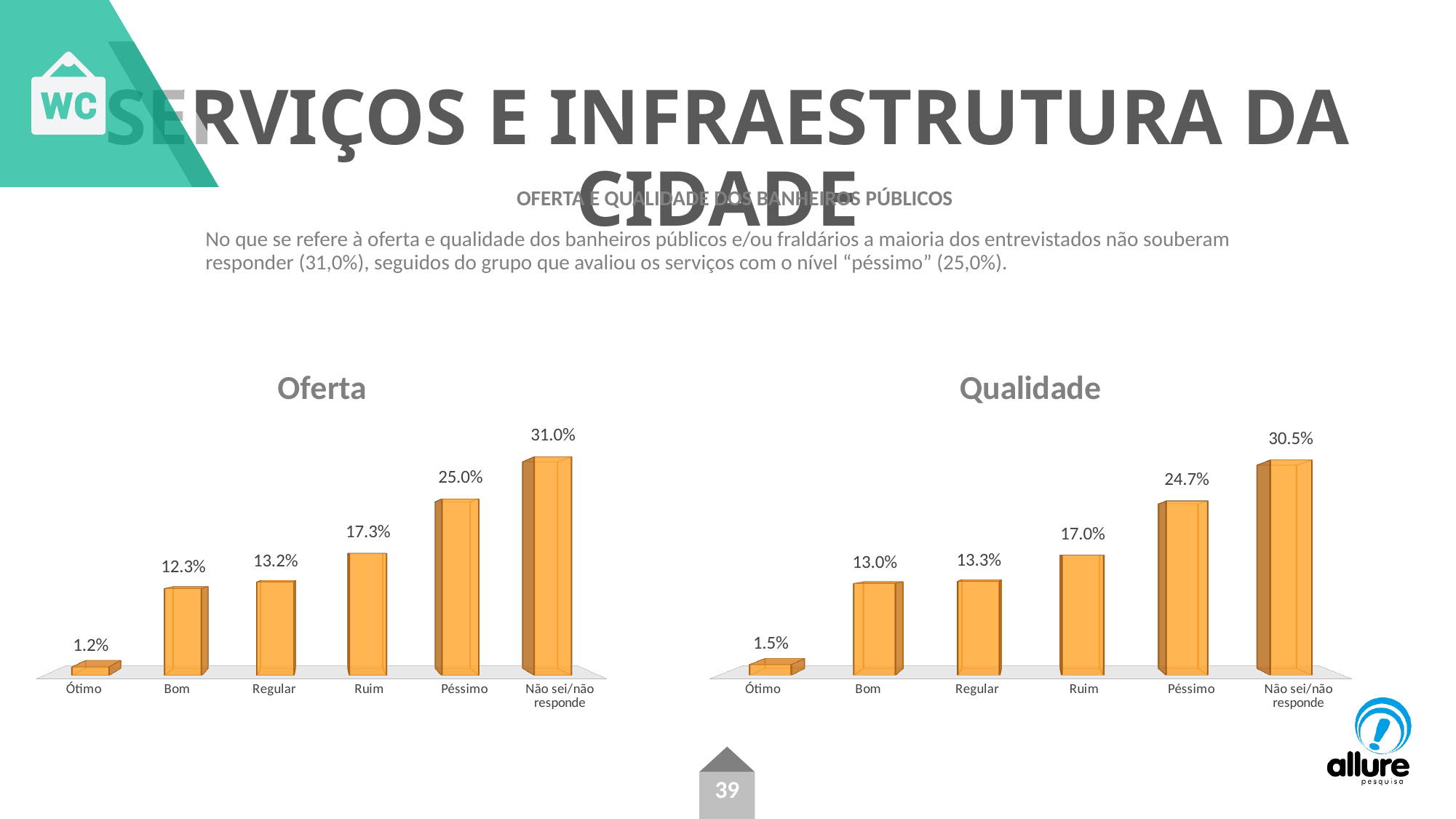
In the 'Oferta' chart, what is the value for 'Não sei/não responde'? 31.0% How many categories are shown in the 'Qualidade' chart? 6 In the 'Qualidade' chart, which category has the highest value? Não sei/não responde In the 'Qualidade' chart, what is the difference between 'Não sei/não responde' and 'Péssimo'? 5.8% In the 'Qualidade' chart, what is the value for 'Regular'? 13.3% In the 'Oferta' chart, which is larger: 'Bom' or 'Ruim'? Ruim In the 'Oferta' chart, which category has the lowest value? Ótimo What type of chart is the 'Oferta' chart? Bar chart In the 'Oferta' chart, do the values rise or fall from 'Ótimo' to 'Não sei/não responde'? Rise In the 'Qualidade' chart, what is the value for 'Péssimo'? 24.7% In the 'Oferta' chart, what is the difference between 'Péssimo' and 'Ruim'? 7.7% Which chart has the higher value for 'Ótimo', 'Oferta' or 'Qualidade'? Qualidade